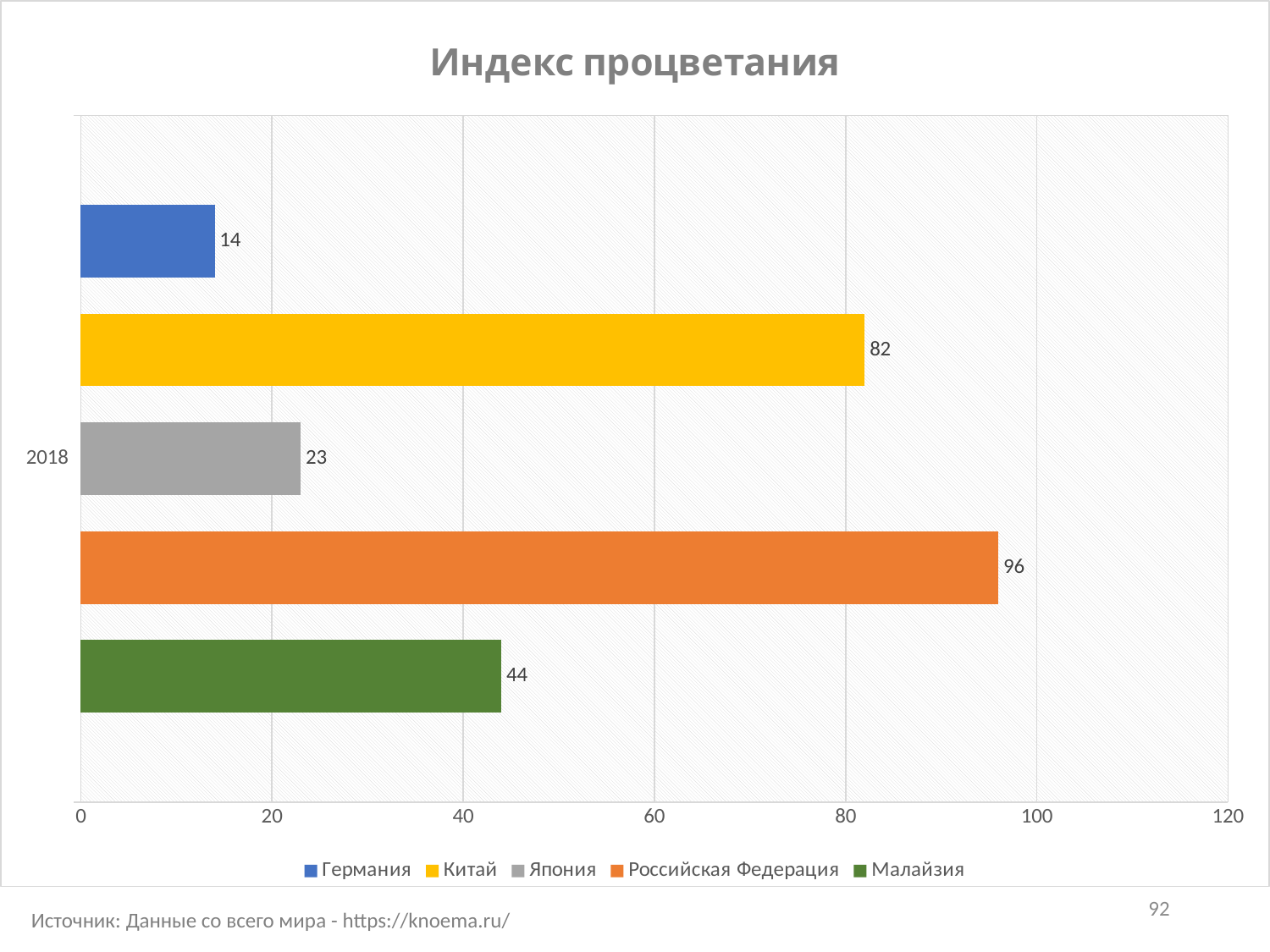
What is the value for Германия in the chart? 14 What is the value for Китай in the chart? 82 What kind of chart is shown on the slide? bar chart Which series has the highest value in the chart? Российская Федерация What is the title of the chart? Индекс процветания How many series does the legend list? 5 Which is larger, the value for Япония or the value for Малайзия? Малайзия What is the value for Малайзия in the chart? 44 What is the value for Российская Федерация in the chart? 96 Which series has the lowest value in the chart? Германия Is the value for Китай greater or less than 80? greater What is the difference between the values for Российская Федерация and Китай? 14